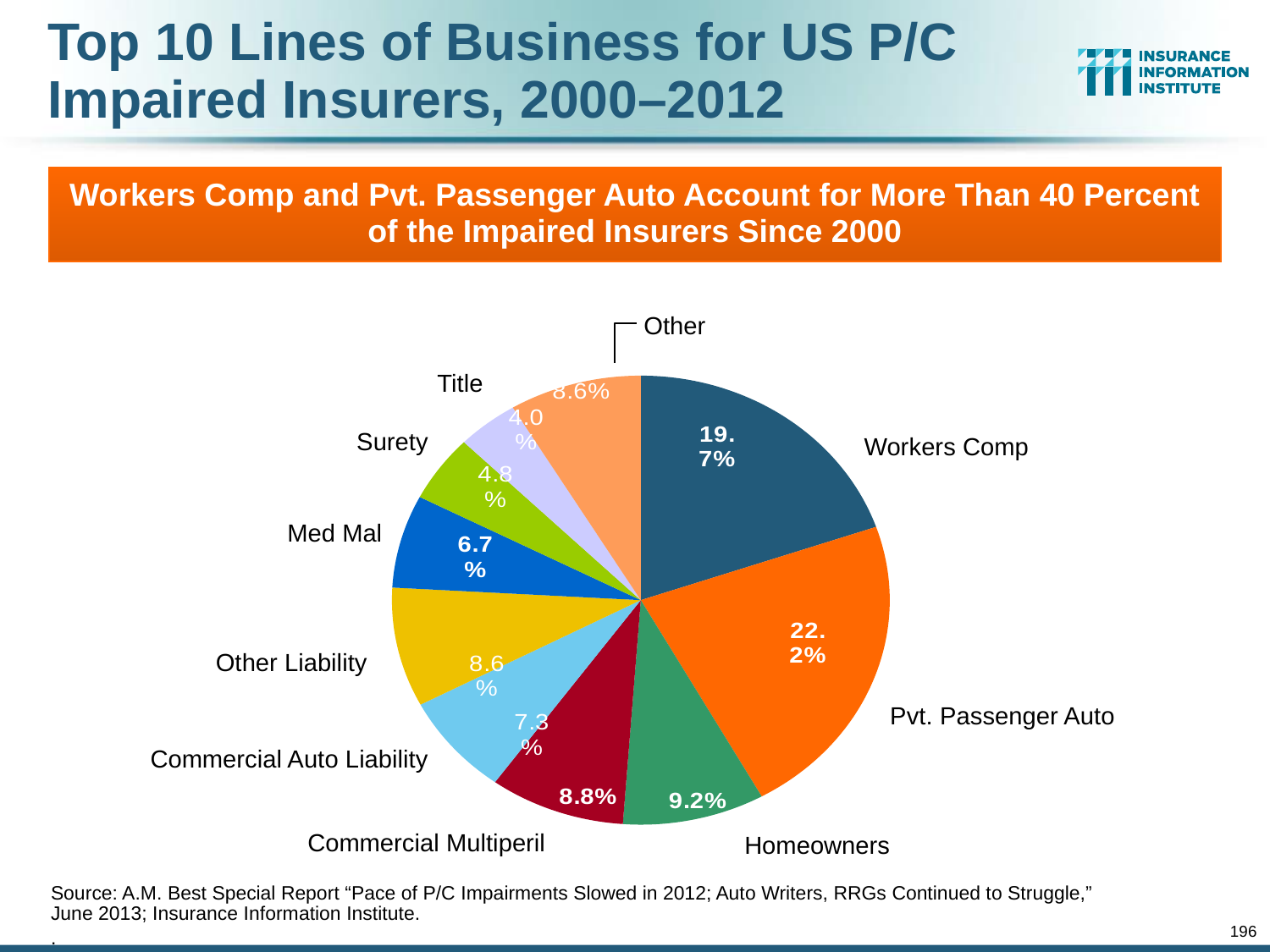
What share of impaired insurers is attributed to Pvt. Passenger Auto? 22.2% Which line of business has the largest slice of the pie? Pvt. Passenger Auto What is the value shown for Surety? 4.8% Which is larger, the Homeowners slice or the Commercial Multiperil slice? Homeowners What is the value shown for Homeowners? 9.2% What share of impaired insurers is attributed to Workers Comp? 19.7% How many slices does the pie chart have? 10 Which line of business has the smallest slice of the pie? Title What is the value shown for Med Mal? 6.7% What kind of chart is shown on the slide? pie chart What is the difference between the Pvt. Passenger Auto share and the Workers Comp share? 2.5 percentage points What is the combined share of Workers Comp and Pvt. Passenger Auto? 41.9%